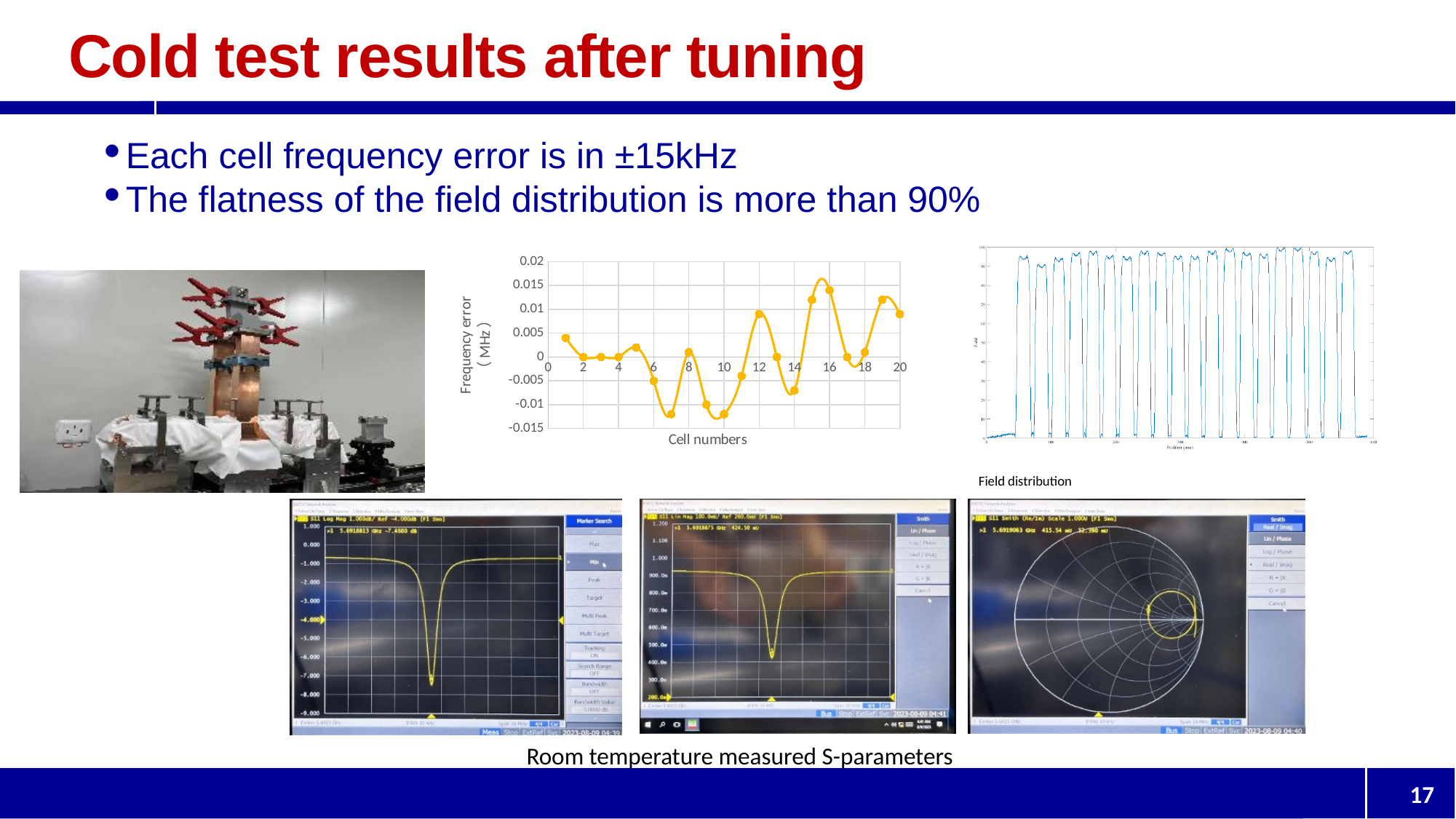
What type of chart is the frequency error chart in the middle of the slide? line chart What is the y-axis title of the frequency error chart? Frequency error (MHz) In the frequency error chart, which has the larger frequency error, cell 16 or cell 7? cell 16 What is the x-axis title of the frequency error chart? Cell numbers In the frequency error chart, is the value for cell 10 greater or less than -0.01? less In the frequency error chart, is the value for cell 7 greater or less than -0.01? less In the frequency error chart, is the value for cell 16 greater or less than 0.01? greater What is the highest tick value shown on the y-axis of the frequency error chart? 0.02 In the frequency error chart, how many cells (data points) are plotted? 20 In the frequency error chart, which has the larger frequency error, cell 12 or cell 14? cell 12